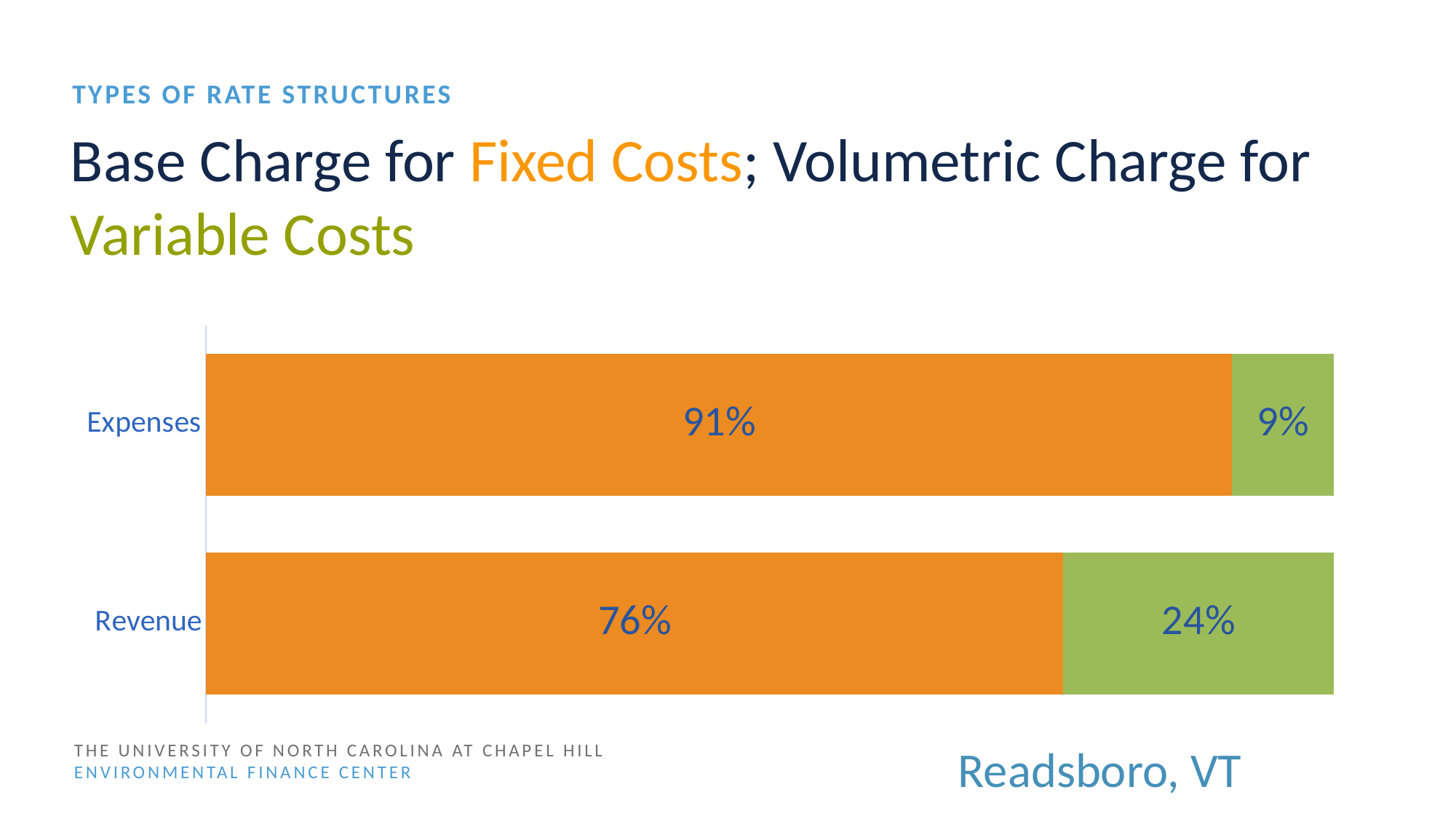
What is the value of the orange segment for Expenses? 91% What is the value of the green segment for Expenses? 9% By how many percentage points does the orange segment for Expenses exceed the orange segment for Revenue? 15 percentage points What kind of chart is shown on the slide? Stacked bar chart What is the value of the orange segment for Revenue? 76% How many categories are shown on the chart? 2 What is the value of the green segment for Revenue? 24% By how many percentage points does the green segment for Revenue exceed the green segment for Expenses? 15 percentage points Which category has the highest orange segment value? Expenses What is the total of the two segments in the Revenue bar? 100% Which category has the larger orange segment, Expenses or Revenue? Expenses Which category has the larger green segment, Expenses or Revenue? Revenue